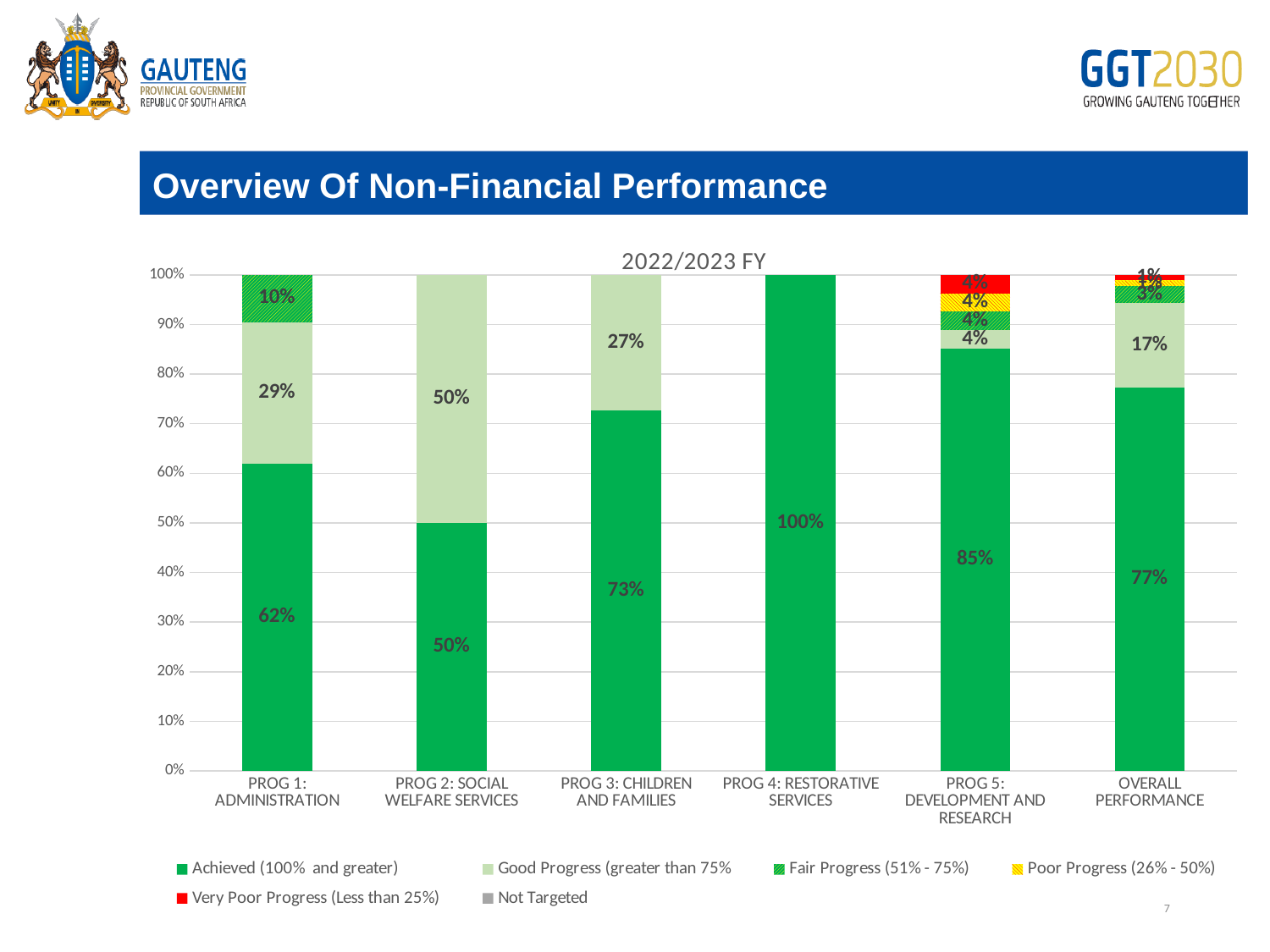
What is the Good Progress (greater than 75%) value for PROG 3: CHILDREN AND FAMILIES? 27% How many categories are shown on the x axis of the chart? 6 What is the difference between the Achieved values for PROG 3: CHILDREN AND FAMILIES and PROG 1: ADMINISTRATION? 11% What is the Achieved (100% and greater) value for PROG 1: ADMINISTRATION? 62% Which category has the lowest Achieved (100% and greater) value? PROG 2: SOCIAL WELFARE SERVICES Which programme has the highest Achieved (100% and greater) value? PROG 4: RESTORATIVE SERVICES What is the title of the chart? 2022/2023 FY What is the Achieved (100% and greater) value for PROG 5: DEVELOPMENT AND RESEARCH? 85% How many series does the legend list? 6 What type of chart is shown on the slide? Stacked bar chart Which has a larger Good Progress (greater than 75%) value, PROG 1: ADMINISTRATION or PROG 2: SOCIAL WELFARE SERVICES? PROG 2: SOCIAL WELFARE SERVICES What is the Achieved (100% and greater) value for OVERALL PERFORMANCE? 77%